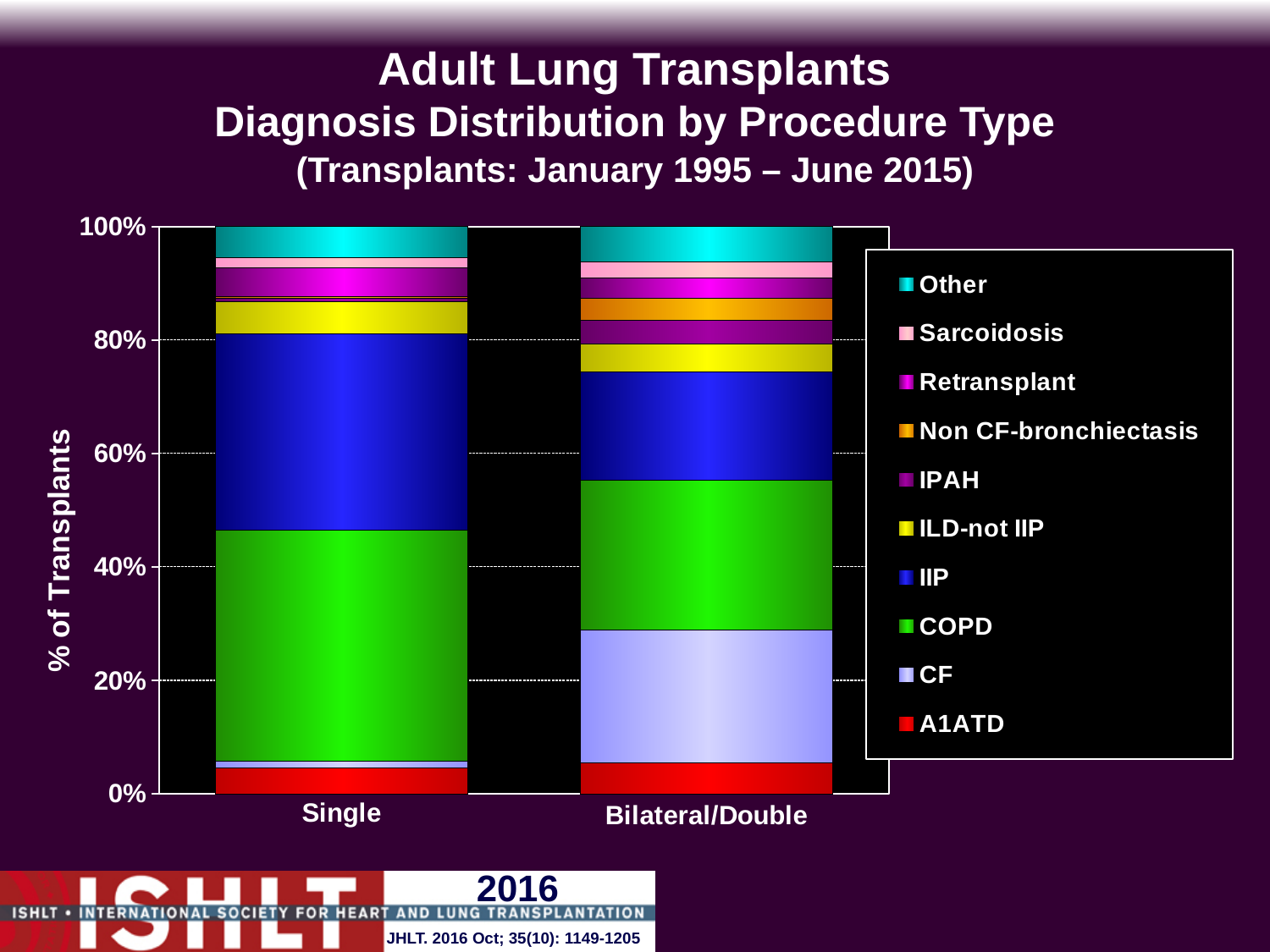
Is the Other segment for Single greater or less than 20%? less How many series does the legend list? 10 How many procedure-type categories are shown on the x axis? 2 What time period of transplants does the chart title say it covers? January 1995 – June 2015 What is the total height of the Single stacked bar? 100% Which procedure type has the larger CF segment, Single or Bilateral/Double? Bilateral/Double Which procedure type has the larger COPD segment, Single or Bilateral/Double? Single Is the CF segment for Bilateral/Double greater or less than 20%? greater What kind of chart is shown on the slide? stacked bar chart Is the COPD segment for Single greater or less than 20%? greater What is the label on the y axis of the chart? % of Transplants Which diagnosis makes up the largest segment of the Single bar? COPD